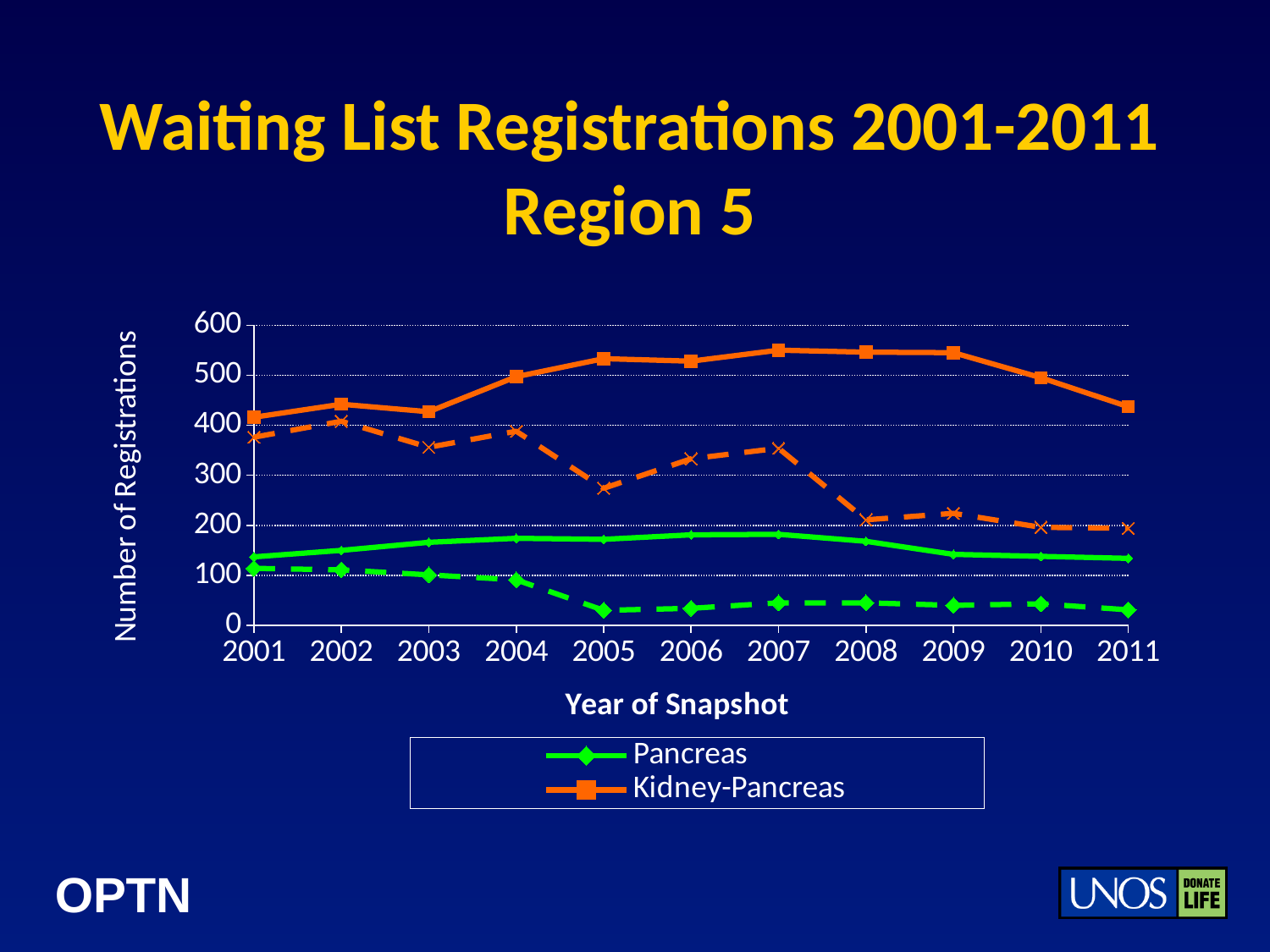
Is the value for the solid Kidney-Pancreas line in 2007 greater or less than 500? greater What is the title of the x axis? Year of Snapshot Is the value for the solid Pancreas line in 2007 greater or less than 200? less In 2005, which series has the larger value on the solid lines: Pancreas or Kidney-Pancreas? Kidney-Pancreas How many series does the chart legend list? 2 Is the value for the solid Kidney-Pancreas line in 2011 greater or less than 500? less What kind of chart is shown on the slide? line chart What is the title of the y axis? Number of Registrations Does the solid Kidney-Pancreas line rise or fall from 2009 to 2011? fall How many years are shown along the x axis of the chart? 11